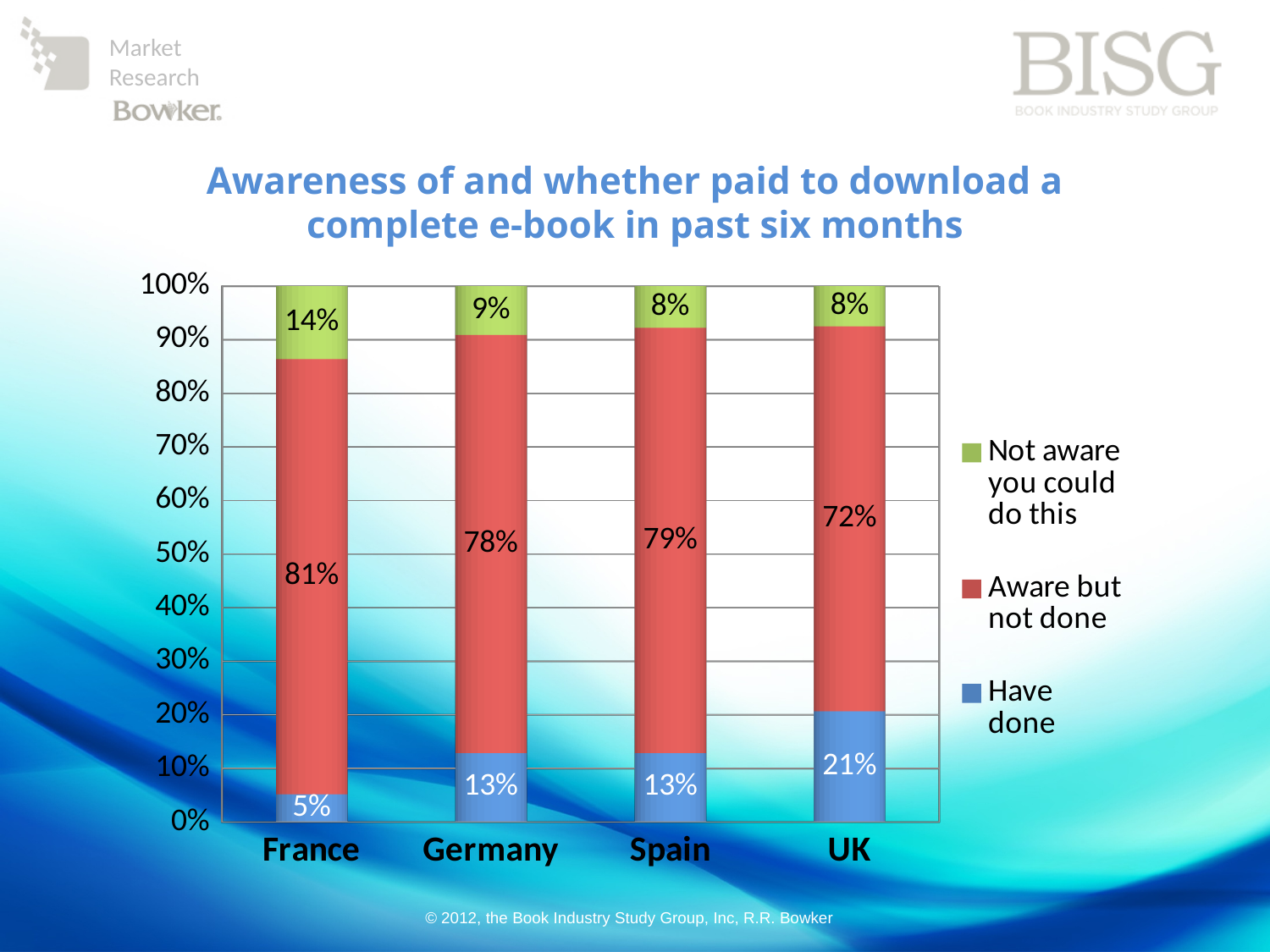
Which colour represents the 'Have done' series? Blue What is the difference between the 'Have done' values for the UK and France? 16% Which country has the highest 'Have done' percentage? UK How many countries are shown on the x axis? 4 Which is larger, the 'Aware but not done' value for Spain or for the UK? Spain Which country has the lowest 'Have done' percentage? France What percentage of respondents in the UK have done (paid to download a complete e-book)? 21% What is the 'Not aware you could do this' value for Germany? 9% Which country has the highest 'Not aware you could do this' percentage? France What is the 'Aware but not done' value for France? 81% How many series does the legend list? 3 What kind of chart is shown on the slide? Stacked bar chart